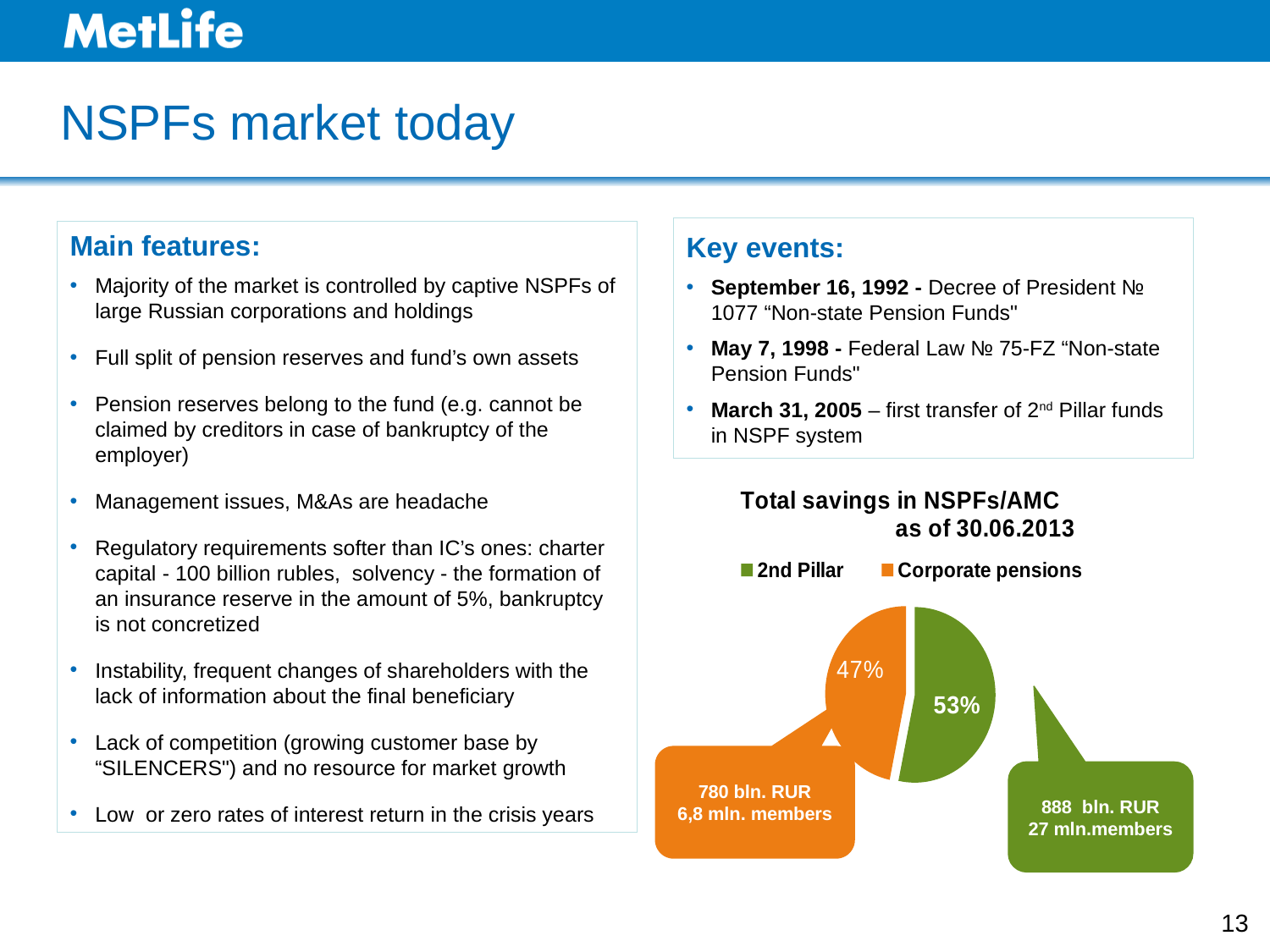
What colour represents Corporate pensions in the chart? orange What share of the pie does Corporate pensions represent? 47% How many series does the chart legend list? 2 What is the difference in percentage points between the 2nd Pillar and Corporate pensions shares? 6 What kind of chart is shown on the slide? pie chart What is the title of the chart? Total savings in NSPFs/AMC as of 30.06.2013 Which category has the smallest share of the pie? Corporate pensions What share of the pie does 2nd Pillar represent? 53% How many slices does the pie chart have? 2 According to the callout for the green slice, how many members are there? 27 mln.members Which slice is larger, 2nd Pillar or Corporate pensions? 2nd Pillar According to the callout for the orange slice, what is the amount of savings in bln. RUR? 780 bln. RUR